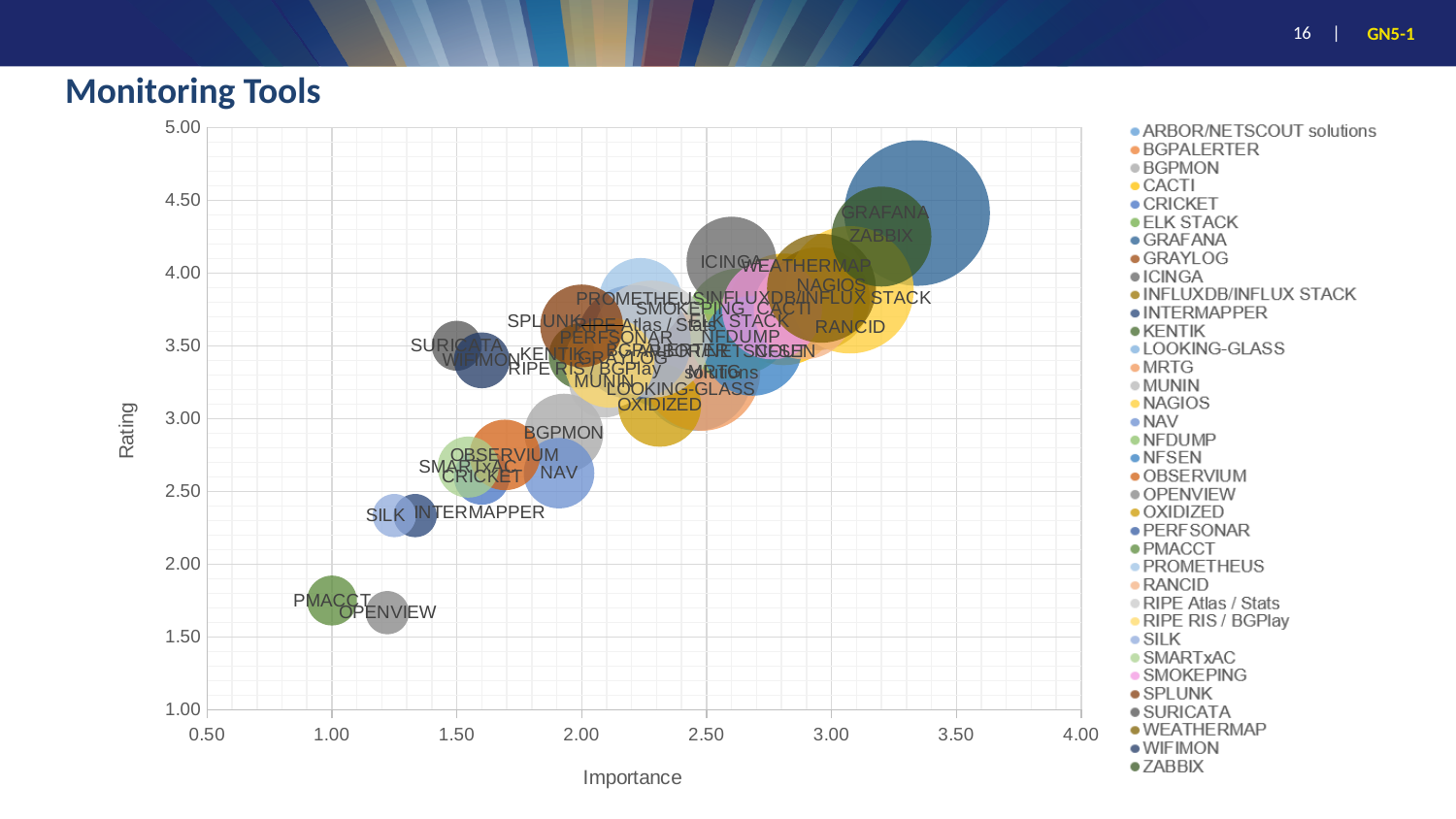
What kind of chart is shown on the slide? Bubble chart Which labeled tool has the lowest Importance value? PMACCT Is the Rating value for PMACCT greater or less than 2.00? less What is the label of the horizontal axis? Importance Is the Importance value for ZABBIX greater or less than 3.00? greater Is the Rating value for INTERMAPPER greater or less than 2.50? less Which has the higher Rating, GRAFANA or PMACCT? GRAFANA How many tools does the legend list? 36 What is the title of the chart? Monitoring Tools